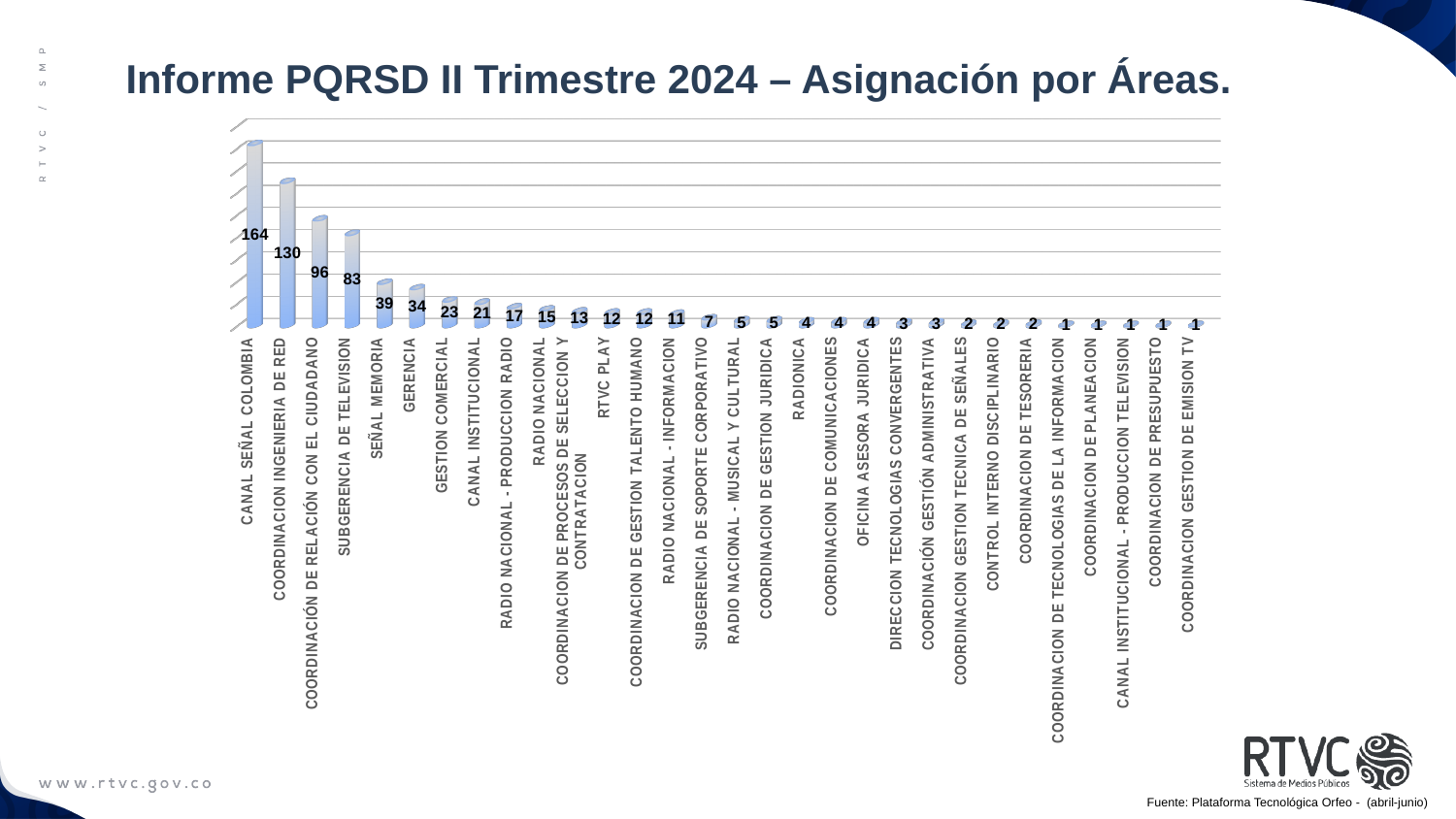
What is the value for RTVC PLAY? 12 How many areas (categories) are shown in the chart? 30 What is the difference between the values for CANAL SEÑAL COLOMBIA and COORDINACION INGENIERIA DE RED? 34 Which has a larger value, SEÑAL MEMORIA or GESTION COMERCIAL? SEÑAL MEMORIA What is the value for GERENCIA? 34 Do the values rise or fall from left to right along the x axis? fall What is the value for SUBGERENCIA DE TELEVISION? 83 What is the value for CANAL SEÑAL COLOMBIA? 164 What is the title of the chart? Informe PQRSD II Trimestre 2024 – Asignación por Áreas. Which area has the highest value? CANAL SEÑAL COLOMBIA What type of chart is shown on the slide? bar chart What is the lowest value shown in the chart? 1